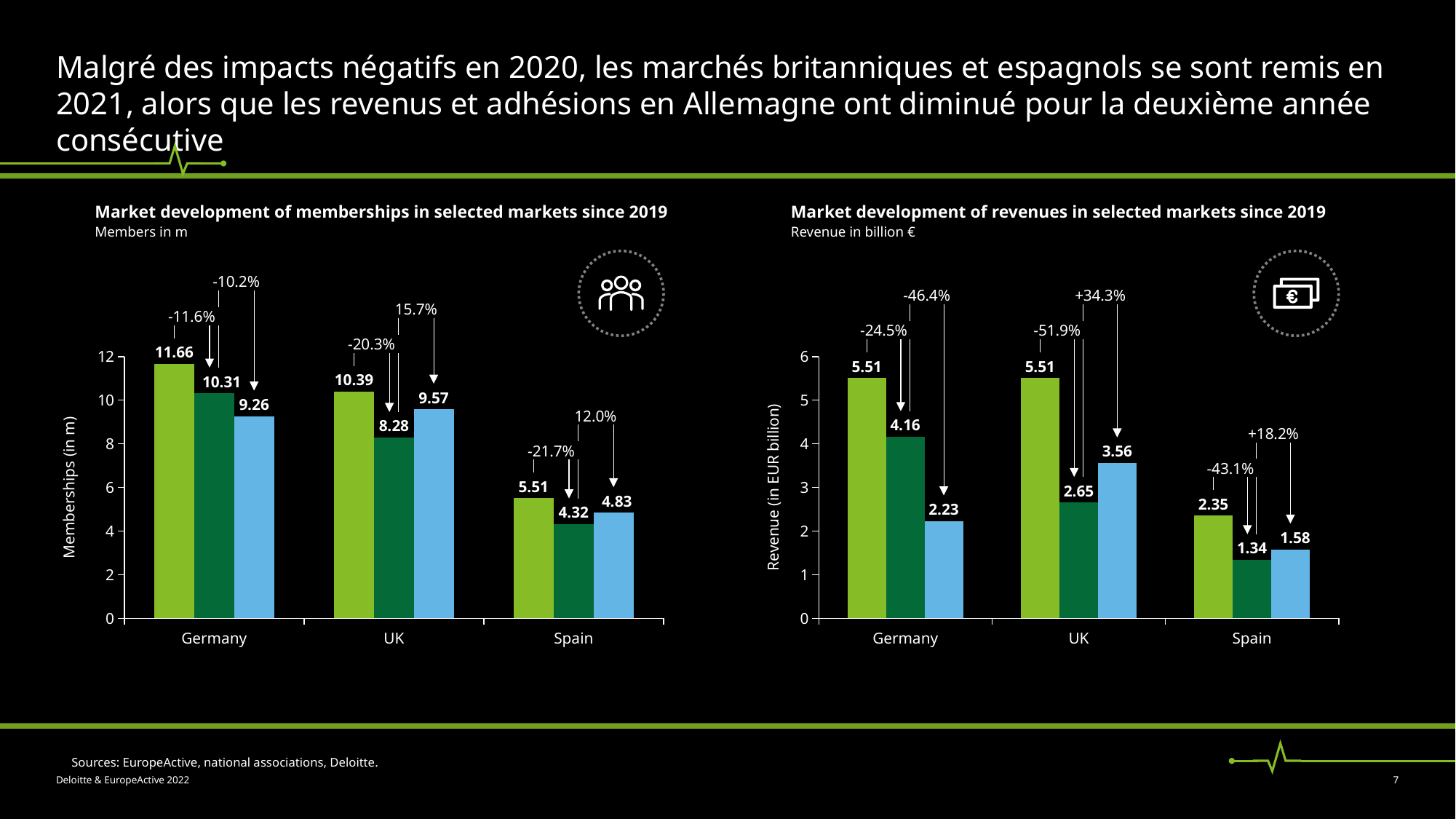
What type of chart is the 'Market development of memberships in selected markets since 2019' chart? bar chart In the 'Market development of memberships' chart, which is larger for Spain: the second (dark green) bar or the third (blue) bar? the third (blue) bar In the 'Market development of memberships' chart, what is the value of the first (light green) bar for Germany? 11.66 What percentage change is shown above the third (blue) bar for UK in the 'Market development of revenues' chart? +34.3% In the 'Market development of revenues' chart, what is the value of the third (blue) bar for Germany? 2.23 In the 'Market development of revenues' chart, what is the difference between the third (blue) bar and the second (dark green) bar for UK? 0.91 In the 'Market development of revenues' chart, what is the value of the second (dark green) bar for Spain? 1.34 In the 'Market development of memberships' chart, what is the value of the third (blue) bar for UK? 9.57 How many countries are shown on the x axis of the 'Market development of revenues' chart? 3 In the 'Market development of revenues' chart, which country has the lowest value among the third (blue) bars? Spain In the 'Market development of memberships' chart, what is the difference between the first (light green) bar and the second (dark green) bar for UK? 2.11 In the 'Market development of memberships' chart, which country has the highest value among the first (light green) bars? Germany